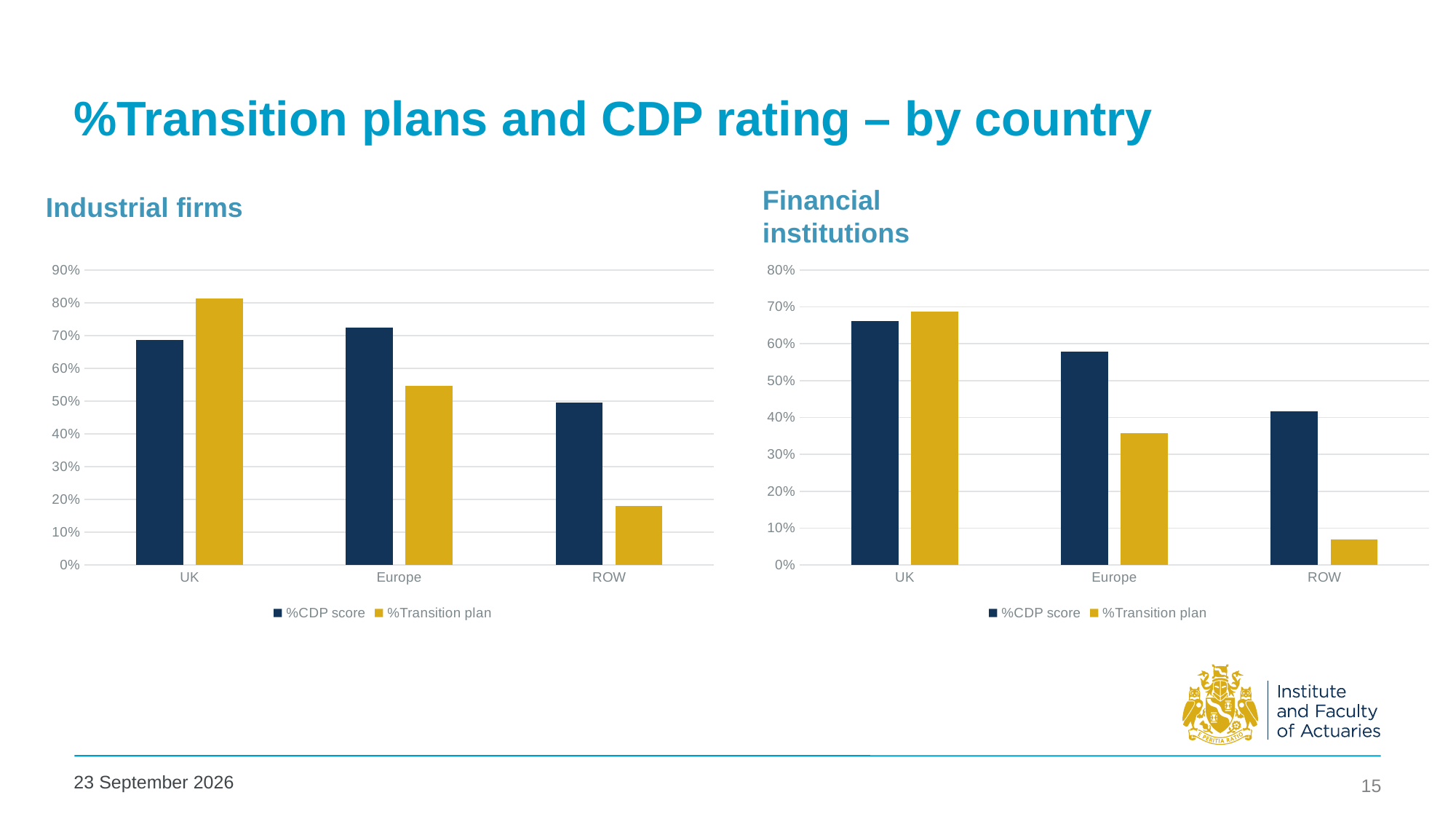
In the Financial institutions chart, which category has the lowest %Transition plan value? ROW In the Financial institutions chart, is the %CDP score for Europe greater or less than 50%? greater In the Financial institutions chart, does the %Transition plan value rise or fall from UK to ROW? fall How many categories are shown on the x axis of the Industrial firms chart? 3 In the Industrial firms chart, is the %Transition plan value for UK greater or less than 80%? greater What kind of chart is the Industrial firms chart? bar chart In the Industrial firms chart, which category has the highest %Transition plan value? UK In the Financial institutions chart, which is larger for ROW: %CDP score or %Transition plan? %CDP score In the Industrial firms chart, which is larger for Europe: %CDP score or %Transition plan? %CDP score In the Industrial firms chart, is the %Transition plan value for ROW greater or less than 20%? less In the Industrial firms chart, which category has the lowest %CDP score? ROW How many series does the legend of the Financial institutions chart list? 2